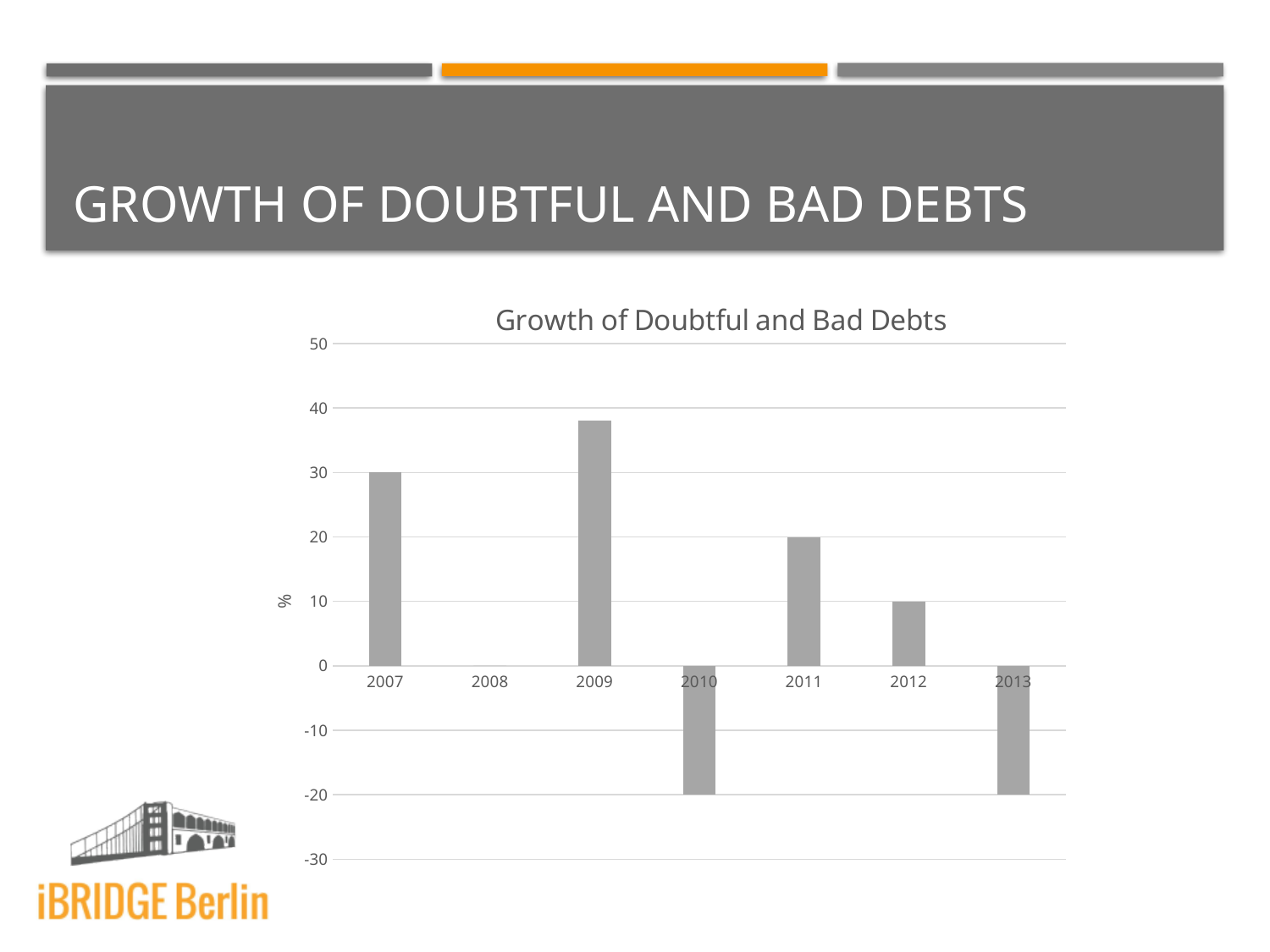
What type of chart is shown on the slide? bar chart How many years are shown on the x axis? 7 Is the value for 2009 greater or less than 40? less Is the value for 2009 greater or less than 30? greater What is the value for 2007? 30 Which year has the highest growth of doubtful and bad debts? 2009 Which is larger, the value for 2007 or the value for 2012? 2007 What is the value for 2012? 10 What is the value for 2010? -20 What is the label on the vertical axis? % What is the difference between the values for 2007 and 2011? 10 What is the value for 2011? 20